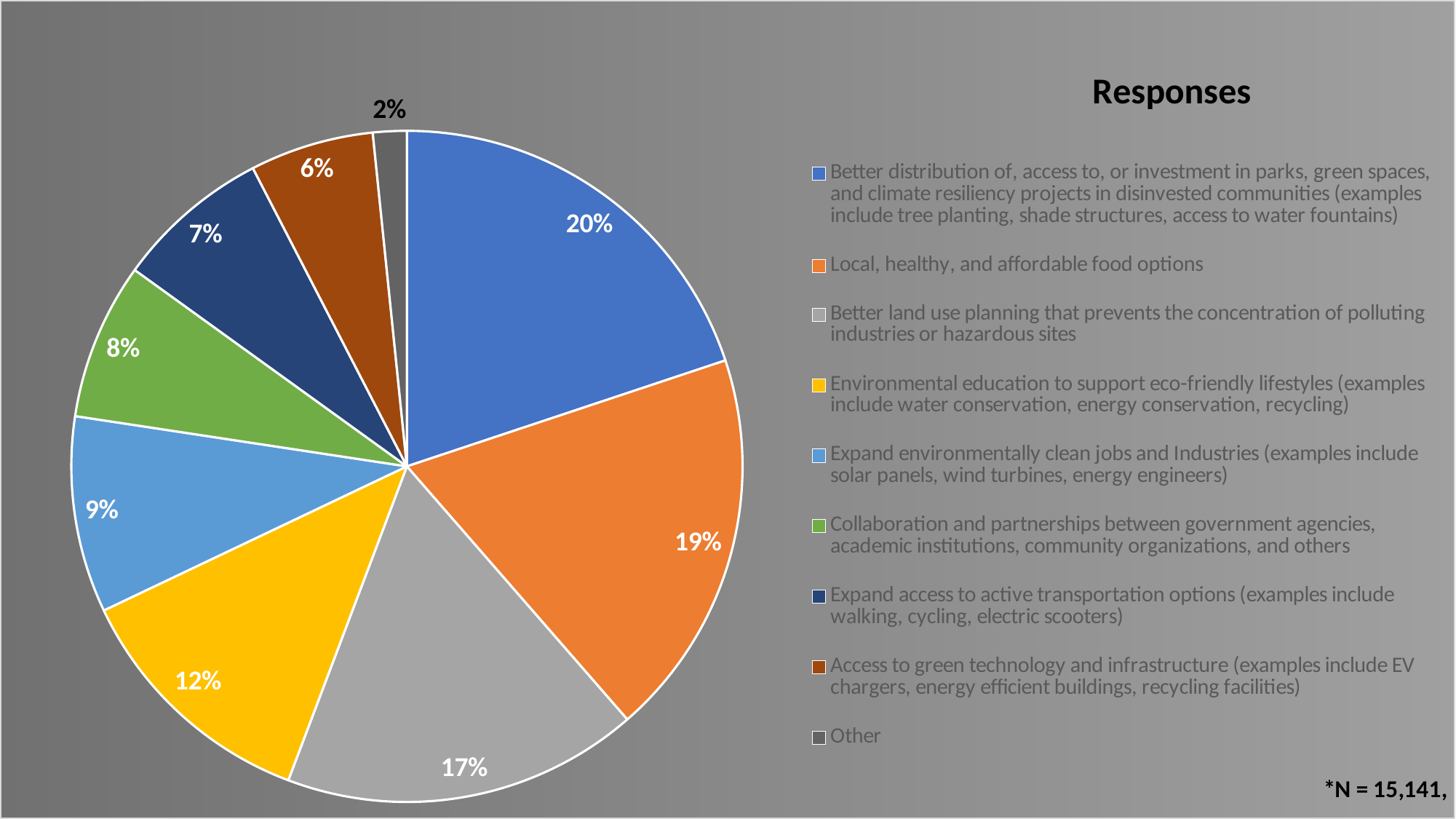
What share of responses is for "Local, healthy, and affordable food options"? 19% What is the difference in percentage points between "Better land use planning that prevents the concentration of polluting industries or hazardous sites" and "Access to green technology and infrastructure"? 11 Which category has the largest share of responses? Better distribution of, access to, or investment in parks, green spaces, and climate resiliency projects in disinvested communities What kind of chart is shown on the slide? Pie chart What share of responses is for "Environmental education to support eco-friendly lifestyles"? 12% What share of responses is for "Expand access to active transportation options"? 7% What colour is the slice for "Collaboration and partnerships between government agencies, academic institutions, community organizations, and others"? Green What share of responses is for "Other"? 2% Which has a larger share: "Expand environmentally clean jobs and Industries" or "Collaboration and partnerships between government agencies, academic institutions, community organizations, and others"? Expand environmentally clean jobs and Industries What is the title of the legend on the slide? Responses How many slices does the pie chart have? 9 Which category has the smallest share of responses? Other